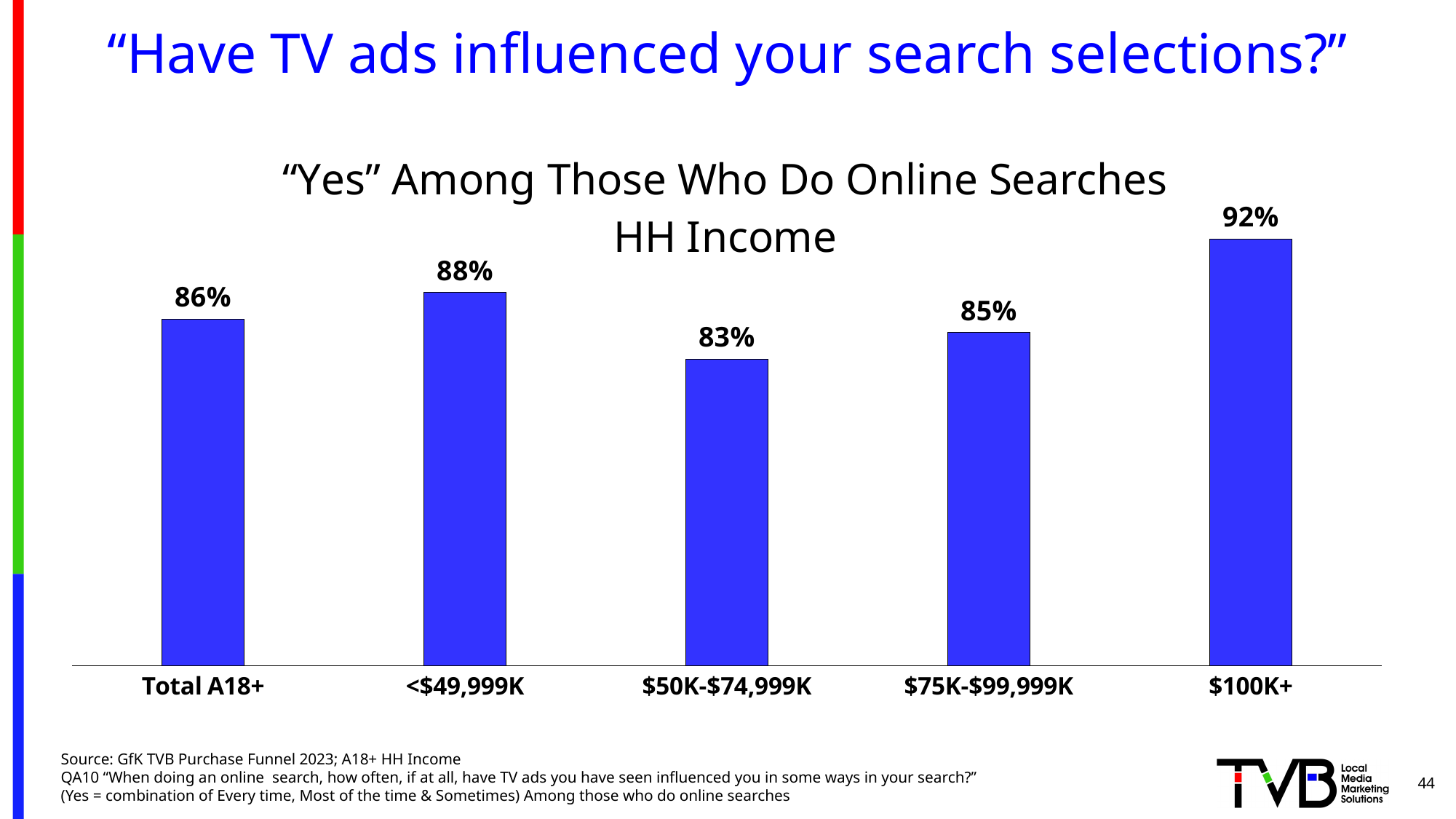
What is the difference between the $100K+ value and the $50K-$74,999K value? 9% What is the value for the $50K-$74,999K income group? 83% What kind of chart is shown on the slide? Bar chart What is the value for the $75K-$99,999K income group? 85% Which category has the lowest value? $50K-$74,999K What colour are the bars in the chart? Blue Which is larger, the value for <$49,999K or the value for $75K-$99,999K? <$49,999K What is the value for Total A18+? 86% How many categories are shown on the x axis? 5 What is the title of the chart? "Yes" Among Those Who Do Online Searches HH Income Which category has the highest value? $100K+ What is the value for the <$49,999K income group? 88%